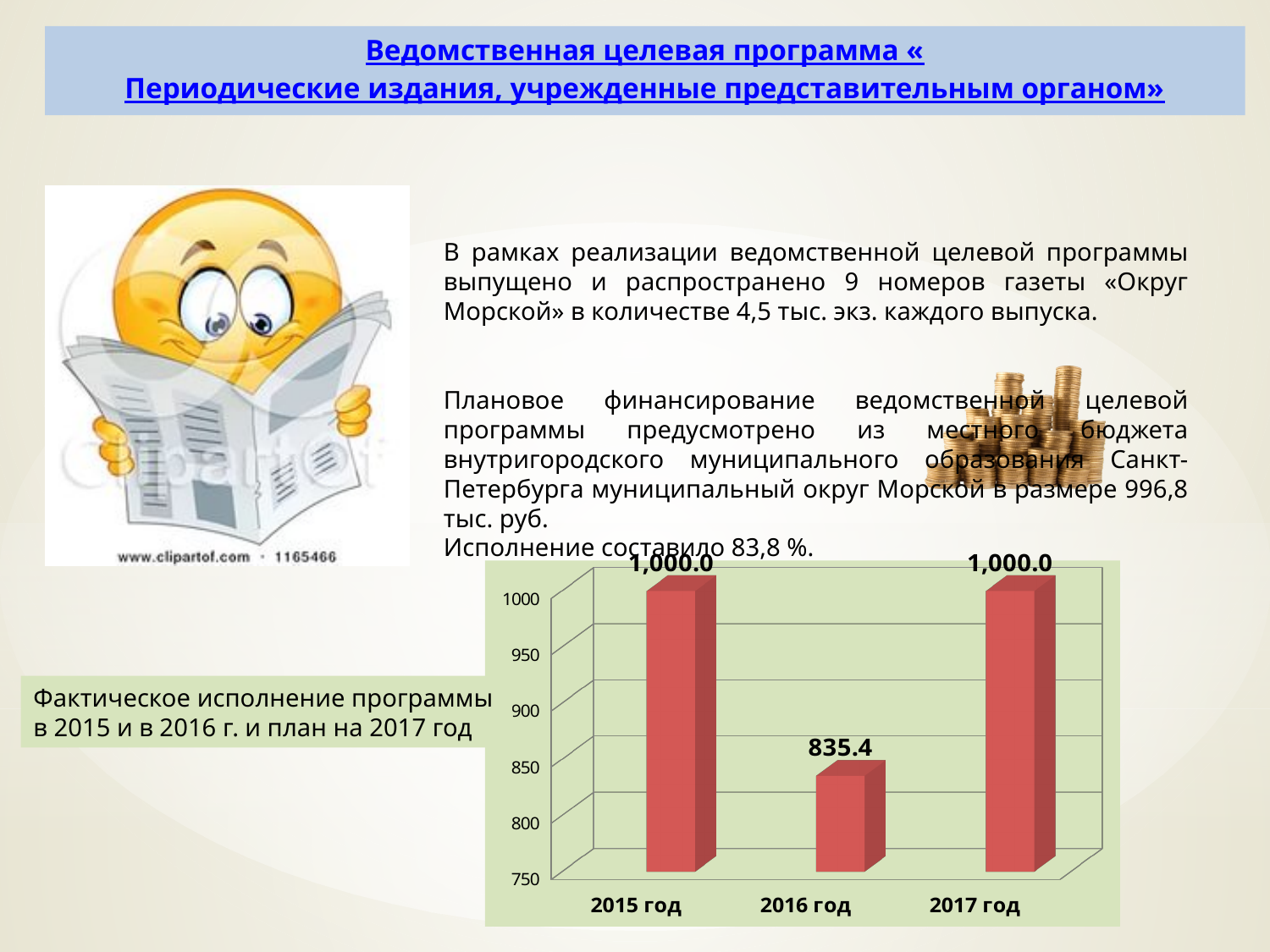
Does the value fall or rise from 2015 год to 2016 год? fall How many categories are shown on the x axis? 3 What is the value for 2016 год? 835.4 What is the value for 2015 год? 1,000.0 What colour are the bars in the chart? red Is the value for 2016 год greater or less than 850? less What kind of chart is shown on the slide? bar chart What is the difference between the values for 2015 год and 2016 год? 164.6 What is the lowest value shown on the vertical axis? 750 Which year has the lowest value? 2016 год What is the value for 2017 год? 1,000.0 Which is larger, the value for 2016 год or the value for 2017 год? 2017 год